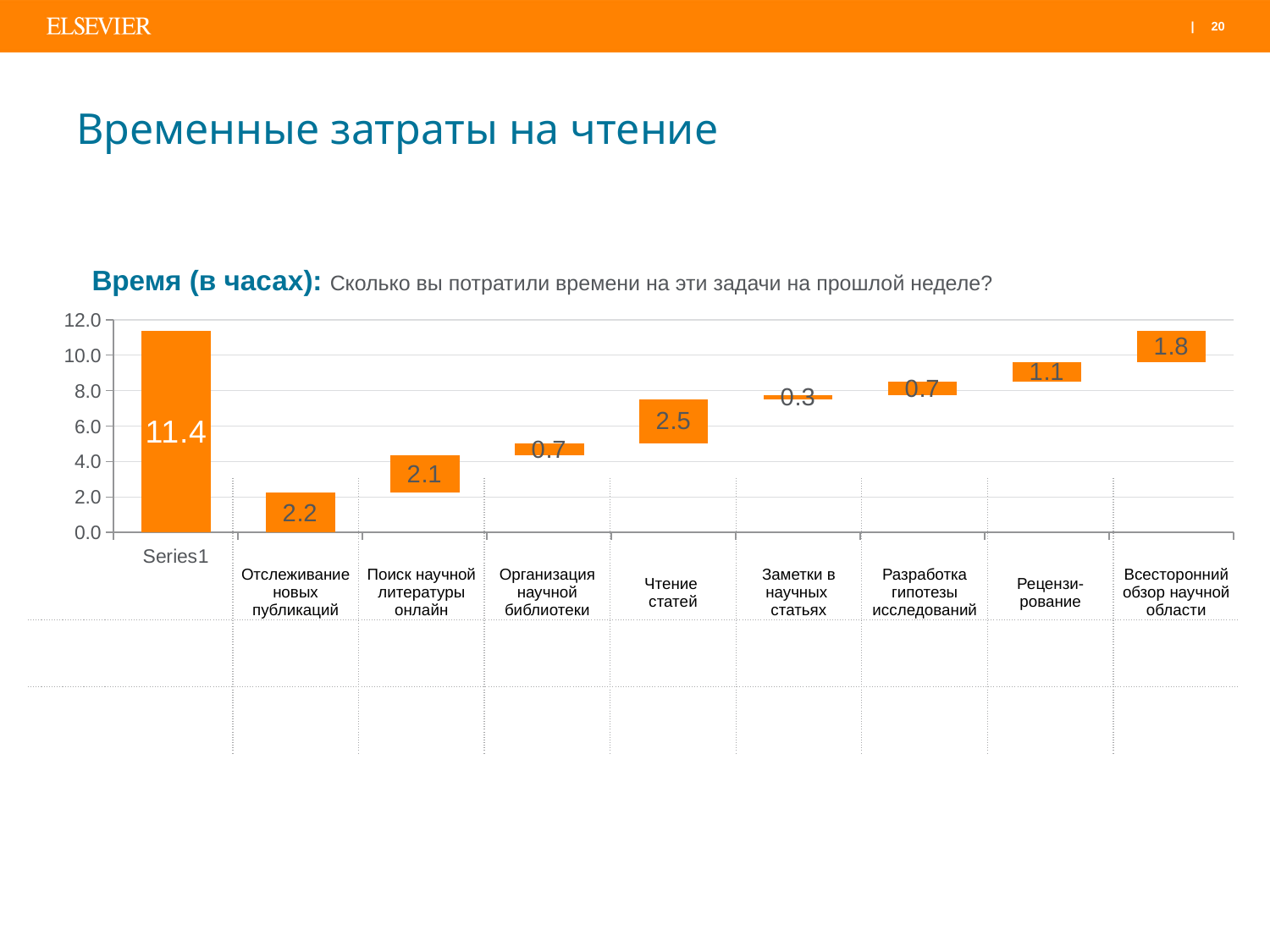
What kind of chart is shown on the slide? bar chart Which task category has the lowest value? Заметки в научных статьях What value is shown for Рецензирование? 1.1 What value is labelled for Всесторонний обзор научной области? 1.8 How many hours are shown for Чтение статей? 2.5 How many labelled categories are shown along the x axis? 9 What is the bold heading printed above the chart? Время (в часах): Is the value for the Series1 bar greater or less than 10.0? greater What value is shown for the Series1 bar? 11.4 Which is larger: the value for Всесторонний обзор научной области or the value for Рецензирование? Всесторонний обзор научной области Which task category (excluding Series1) has the highest value? Чтение статей What is the difference between the values for Отслеживание новых публикаций and Поиск научной литературы онлайн? 0.1